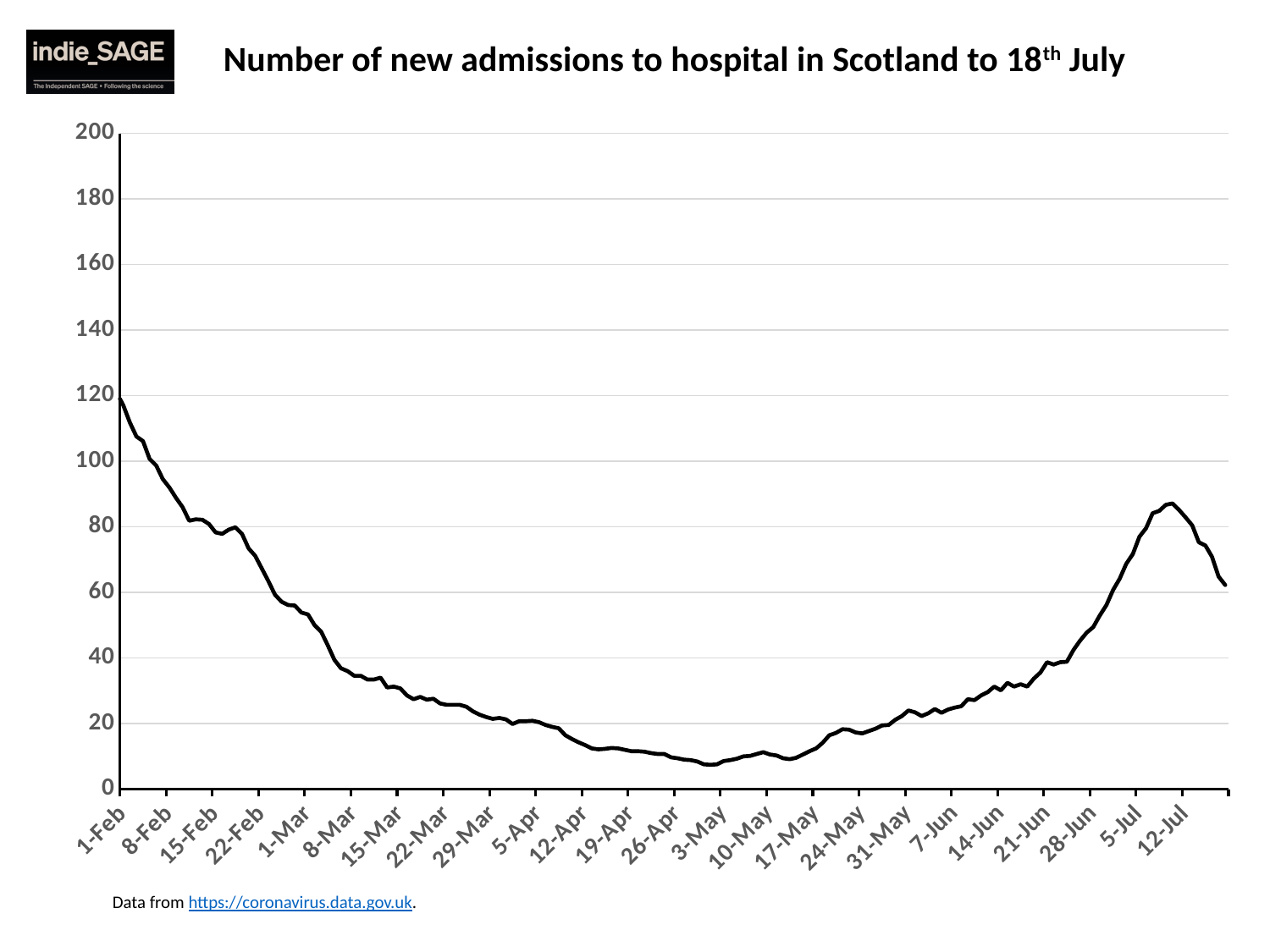
Does the line rise or fall between 31-May and 5-Jul? rise Is the value for 8-Mar greater or less than 60? less Is the value for 5-Jul greater or less than 60? greater Is the value for 3-May greater or less than 20? less What kind of chart is shown on the slide? line chart At which labelled date is the line at its highest value? 1-Feb Does the line rise or fall between 1-Feb and 3-May? fall Which has the larger value, 1-Feb or 12-Jul? 1-Feb Around which labelled date does the line reach its lowest point? 3-May What is the title of the chart? Number of new admissions to hospital in Scotland to 18th July What is the highest value shown on the y axis? 200